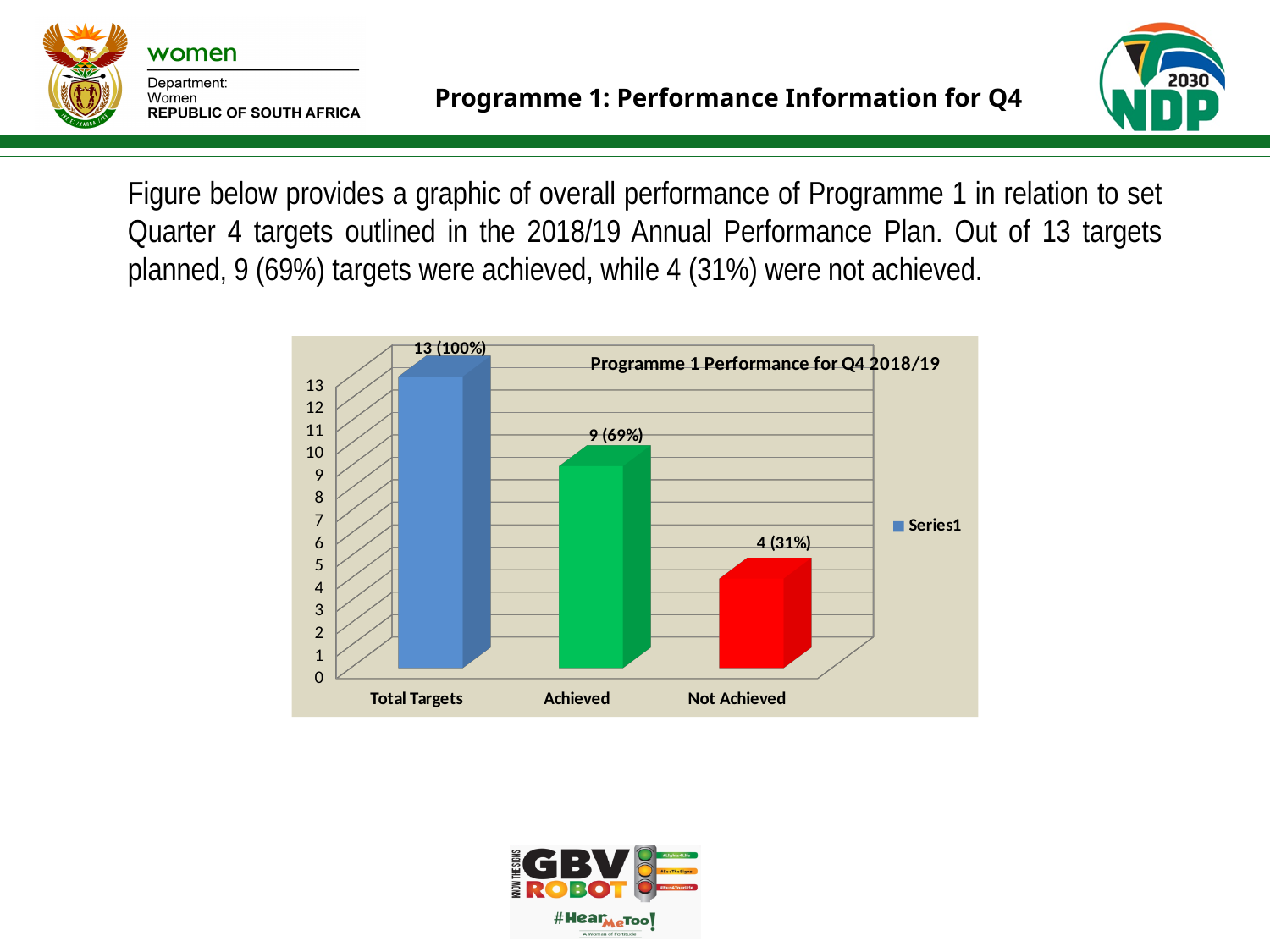
What is the value shown for Achieved? 9 (69%) Which is larger, the value for Achieved or the value for Not Achieved? Achieved What is the value shown for Not Achieved? 4 (31%) Which category has the highest value? Total Targets How many series does the legend list? 1 What is the difference between the number of targets Achieved and Not Achieved? 5 What is the value shown for Total Targets? 13 (100%) How many categories are shown on the x axis? 3 Which category has the lowest value? Not Achieved What kind of chart is shown? bar chart What is the title of the chart? Programme 1 Performance for Q4 2018/19 Is the value for Achieved greater or less than 5? greater